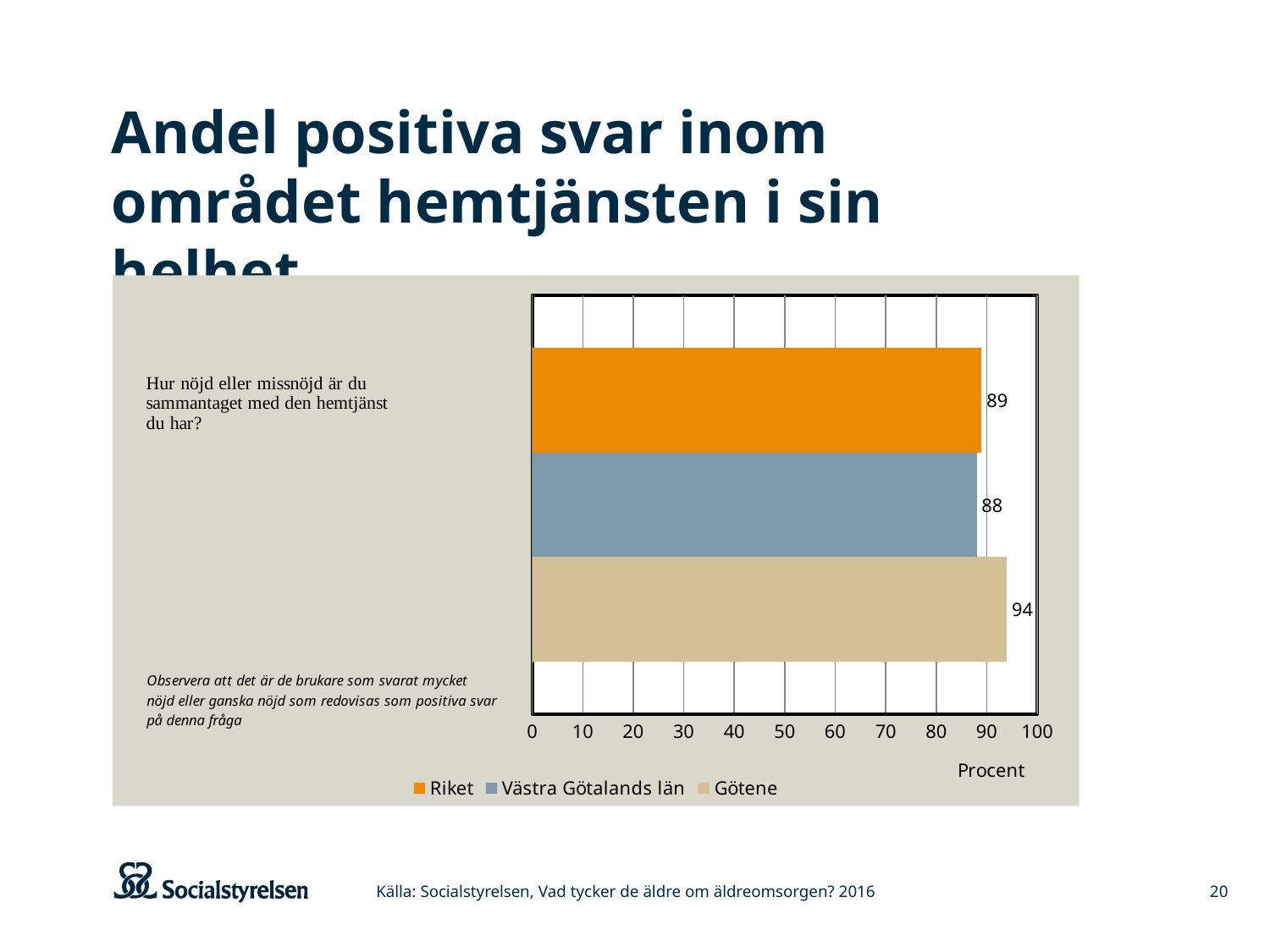
Which is larger, the value for Götene or the value for Västra Götalands län? Götene What is the value for Götene? 94 What kind of chart is shown on the slide? bar chart What is the label on the horizontal axis of the chart? Procent Which series has the lowest value? Västra Götalands län What is the difference between the values for Riket and Västra Götalands län? 1 What is the value for Västra Götalands län? 88 Which series has the highest value? Götene What is the value for Riket? 89 How many series does the legend list? 3 Is the value for Götene greater or less than 90? greater What is the difference between the values for Götene and Riket? 5